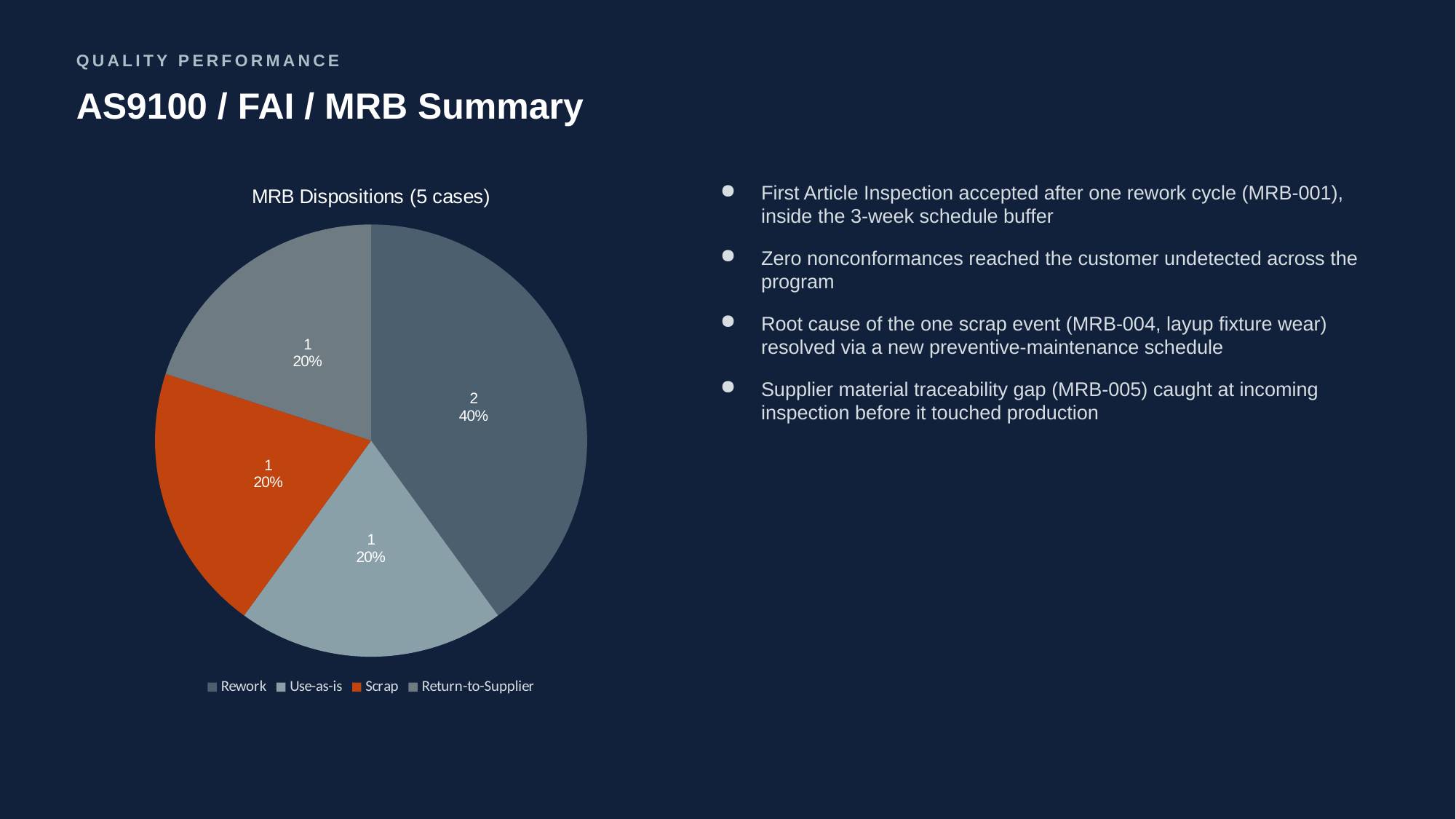
How many cases are in the Scrap slice? 1 How many cases are in the Rework slice? 2 What share of the pie does Rework represent? 40% Which has more cases, Rework or Return-to-Supplier? Rework How many slices does the pie chart have? 4 What is the title of the chart? MRB Dispositions (5 cases) What kind of chart is shown on the slide? pie chart Which disposition is shown in orange in the pie chart? Scrap What share of the pie does Scrap represent? 20% What is the difference in number of cases between Rework and Use-as-is? 1 Which disposition has the largest slice of the pie? Rework What is the total number of cases across all slices of the pie? 5